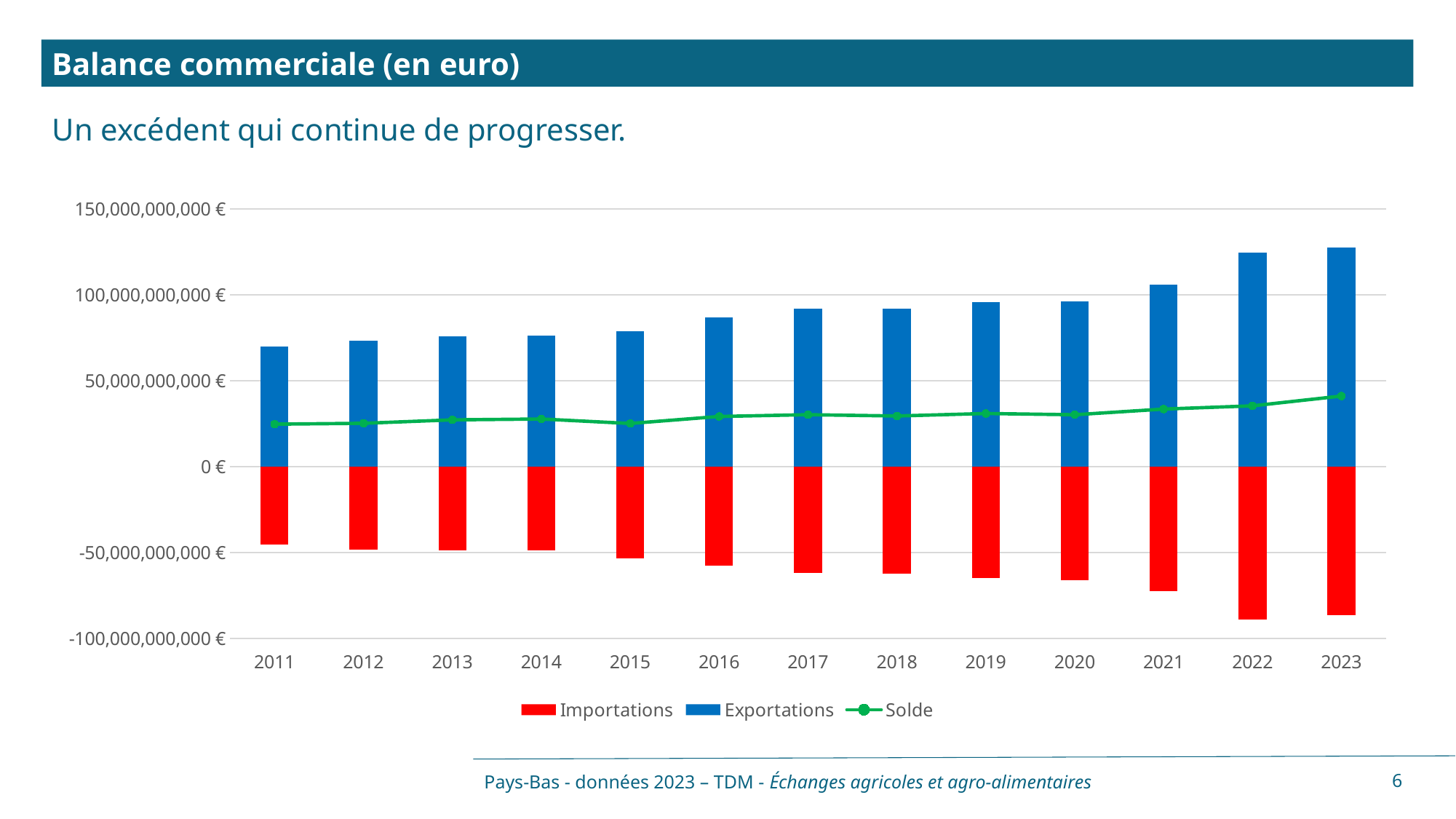
How many series does the chart legend list? 3 Is the Exportations value for 2023 greater or less than 100,000,000,000 €? greater Is the Solde value for 2023 greater or less than 50,000,000,000 €? less What colour are the Importations bars in the chart? Red How many years are shown on the x axis of the chart? 13 In which year is the Exportations bar the lowest? 2011 Is the Exportations value for 2016 greater or less than 100,000,000,000 €? less Which is larger, the Exportations value for 2021 or the Exportations value for 2015? 2021 In which year does the Solde line reach its highest point? 2023 Do the Exportations values generally rise or fall from 2011 to 2023? rise In which year is the Exportations bar the highest? 2023 What kind of chart is shown on the slide? Bar chart with a line series